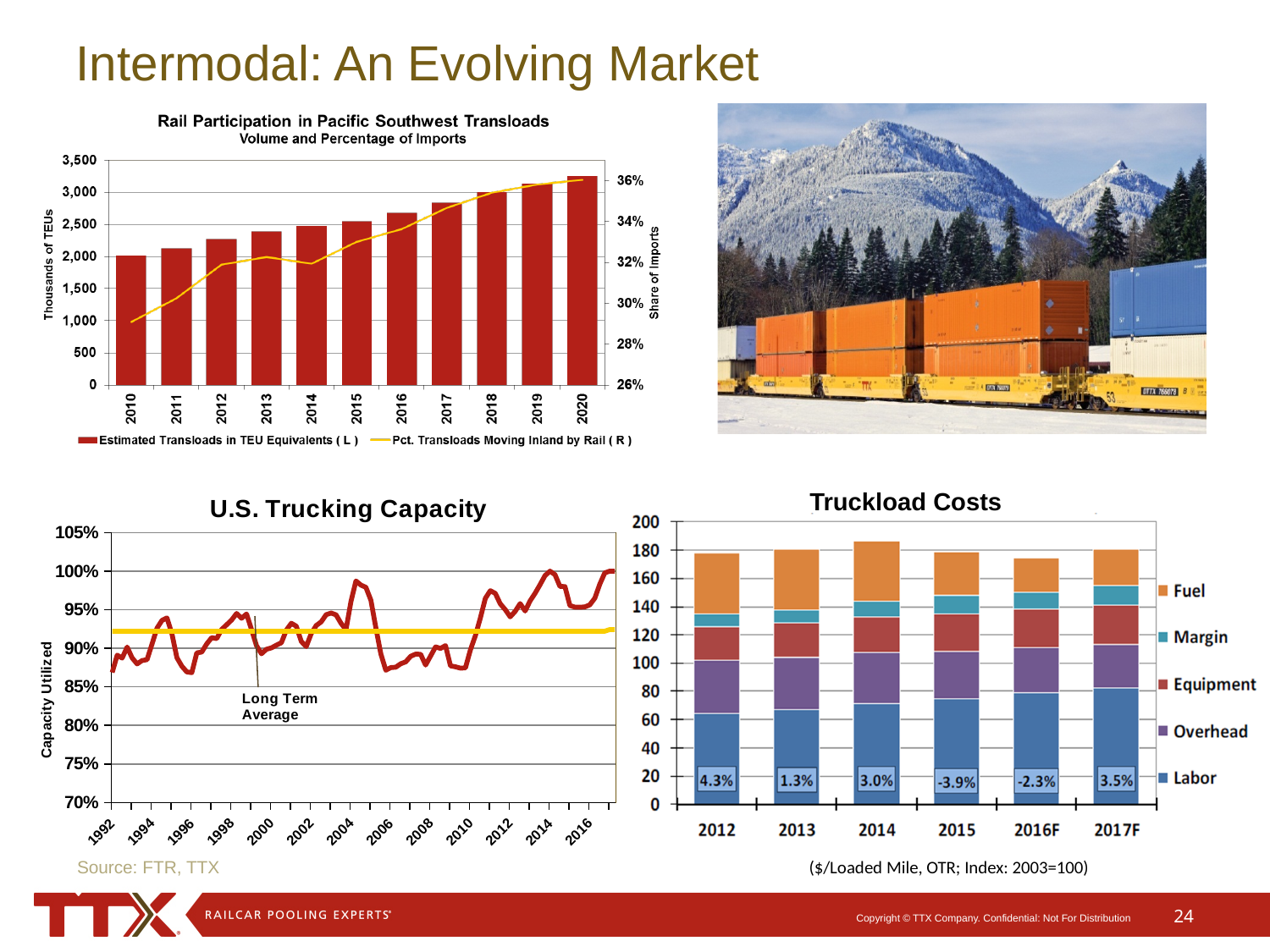
In the Truckload Costs chart, what percentage label is printed on the 2012 bar? 4.3% In the Rail Participation in Pacific Southwest Transloads chart, how many years are shown on the x axis? 11 In the Rail Participation in Pacific Southwest Transloads chart, is the bar for 2020 greater or less than 3,000 thousand TEUs? greater In the Rail Participation in Pacific Southwest Transloads chart, which year has the tallest bar? 2020 What kind of chart is the U.S. Trucking Capacity chart? line chart In the Truckload Costs chart, is the total for 2014 greater or less than 180? greater In the Truckload Costs chart, which year has the tallest stacked bar? 2014 In the Truckload Costs chart, how many series does the legend list? 5 In the Truckload Costs chart, how many years are shown on the x axis? 6 In the Rail Participation in Pacific Southwest Transloads chart, do the bars rise or fall from 2010 to 2020? rise In the Truckload Costs chart, what percentage label is printed on the 2015 bar? -3.9%